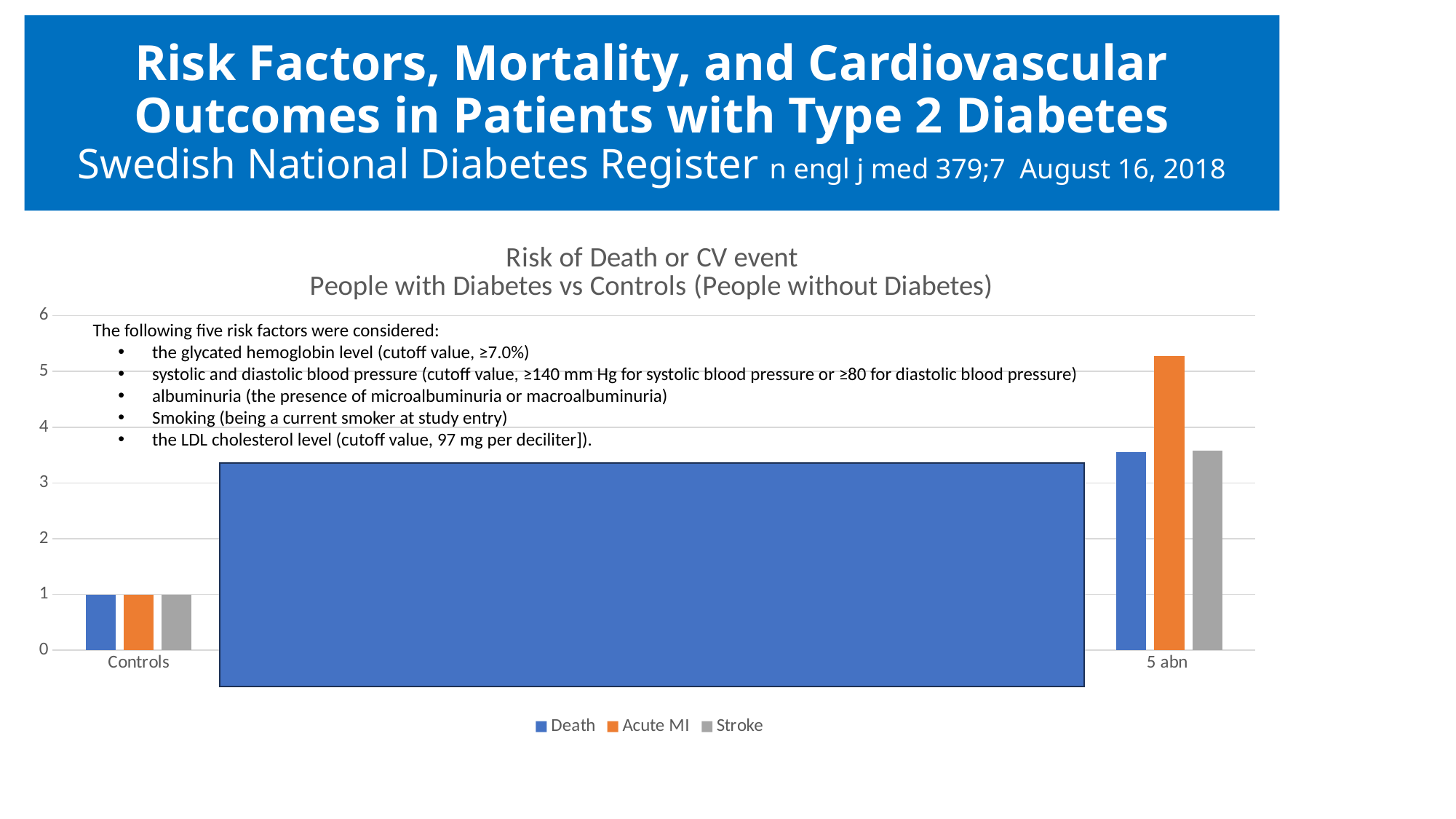
Which series has the highest value for the 5 abn category? Acute MI Which is larger: the Death value for Controls or the Death value for 5 abn? 5 abn Is the Acute MI value for 5 abn greater or less than 5? greater Is the Death value for 5 abn greater or less than 4? less For the 5 abn category, which is larger: the Acute MI value or the Death value? Acute MI What are the three series listed in the chart legend? Death, Acute MI, Stroke Is the Stroke value for 5 abn greater or less than 3? greater Do the values rise or fall from Controls to 5 abn? rise What is the value of the Stroke bar for Controls? 1 What kind of chart is shown on the slide? bar chart What is the value of the Death bar for Controls? 1 How many series does the chart legend list? 3